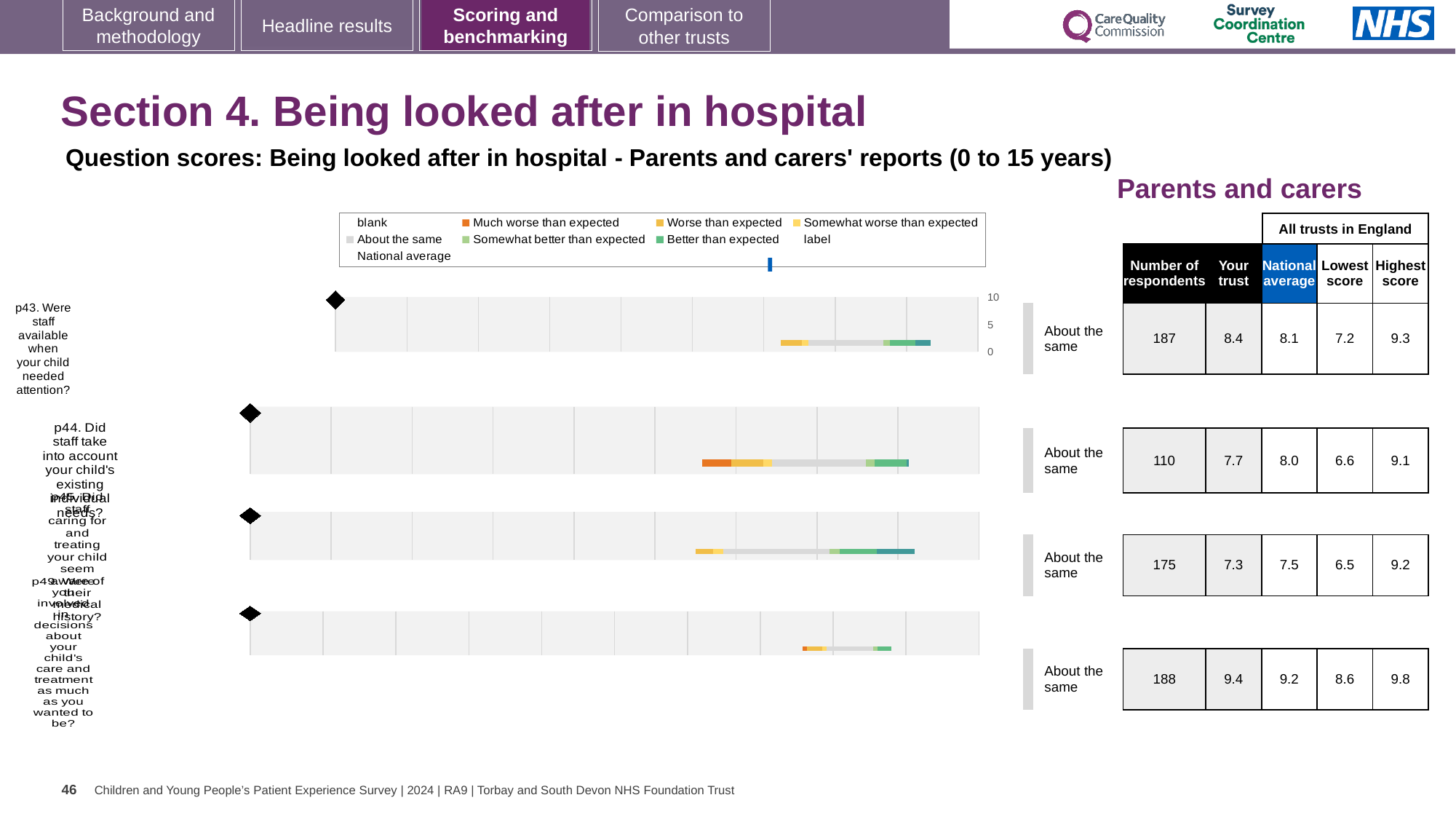
For question p43, what is the national average score shown? 8.1 For question p49 (fourth row), what is the difference between the highest score and the lowest score among all trusts in England? 1.2 Which question row has the highest 'Your trust' score? p49 (fourth row), 9.4 What benchmark category is shown next to each of the four question charts? About the same Which question row has the lowest 'Your trust' score? p45 (third row), 7.3 For question p43, what is the difference between the 'Your trust' score and the national average? 0.3 For question p49 (fourth row), what is the highest score among all trusts in England? 9.8 How many respondents are shown for question p43? 187 For question p44, which is larger: the 'Your trust' score or the national average? National average (8.0 vs 7.7) How many questions (rows) are plotted in the chart area on this slide? 4 For question p43 (Were staff available when your child needed attention?), what is the 'Your trust' score shown? 8.4 What kind of chart is used to show the question scores on this slide? bar chart